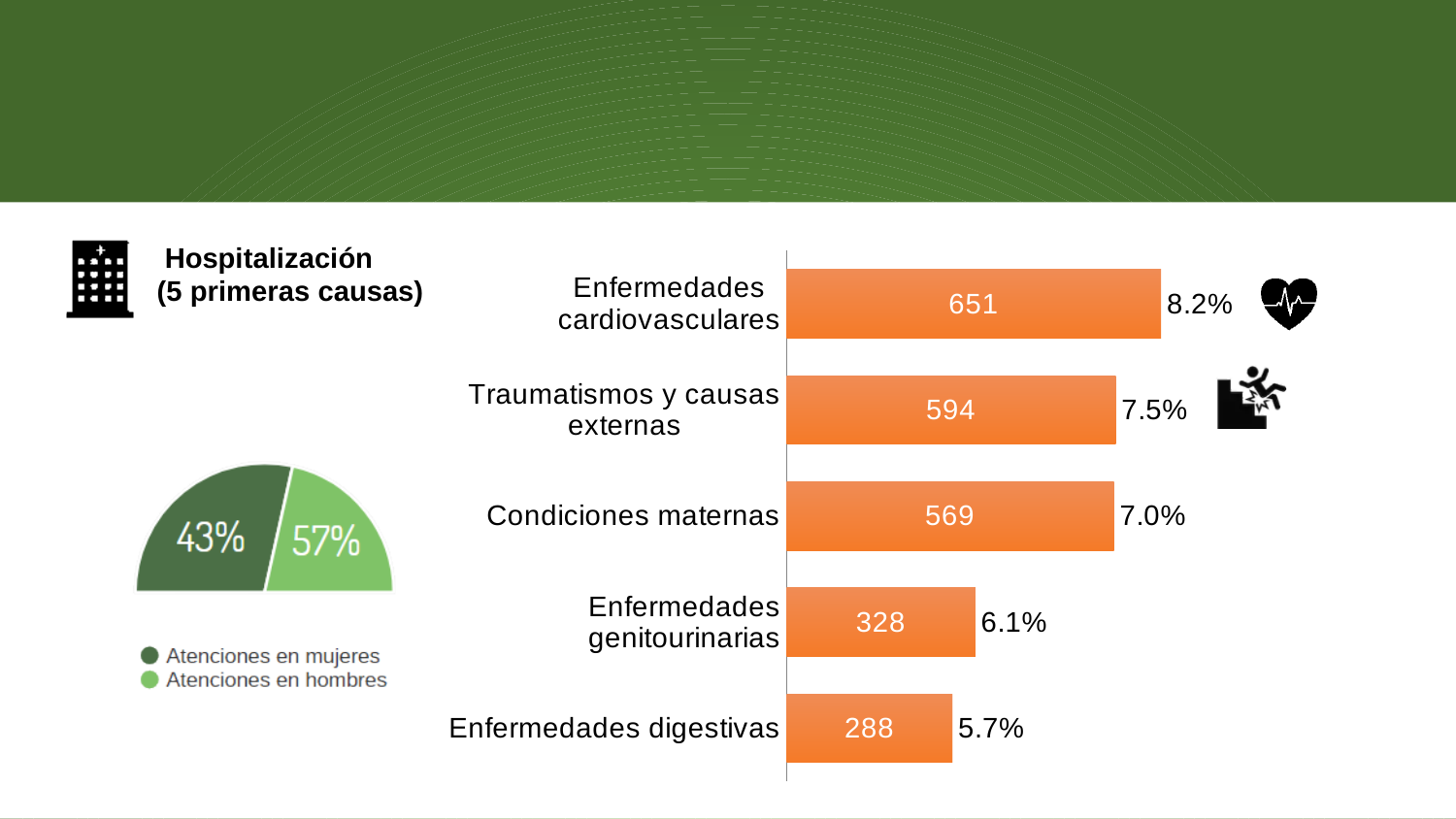
How many categories are shown in the bar chart of hospitalization causes? 5 In the half-pie chart on the left, which group has the larger share: Atenciones en mujeres or Atenciones en hombres? Atenciones en hombres In the bar chart of hospitalization causes, which category has the highest value? Enfermedades cardiovasculares In the bar chart of hospitalization causes, what is the difference between the values for Enfermedades cardiovasculares and Traumatismos y causas externas? 57 What kind of chart is used to show the hospitalization causes? Bar chart In the half-pie chart on the left, what share is shown for Atenciones en hombres? 57% In the bar chart of hospitalization causes, what is the value for Enfermedades cardiovasculares? 651 In the bar chart of hospitalization causes, what is the value for Condiciones maternas? 569 In the bar chart of hospitalization causes, which category has the lowest value? Enfermedades digestivas In the half-pie chart on the left, what share is shown for Atenciones en mujeres? 43% In the bar chart of hospitalization causes, which is larger: the value for Enfermedades genitourinarias or Enfermedades digestivas? Enfermedades genitourinarias In the bar chart of hospitalization causes, what percentage is shown next to the bar for Enfermedades genitourinarias? 6.1%